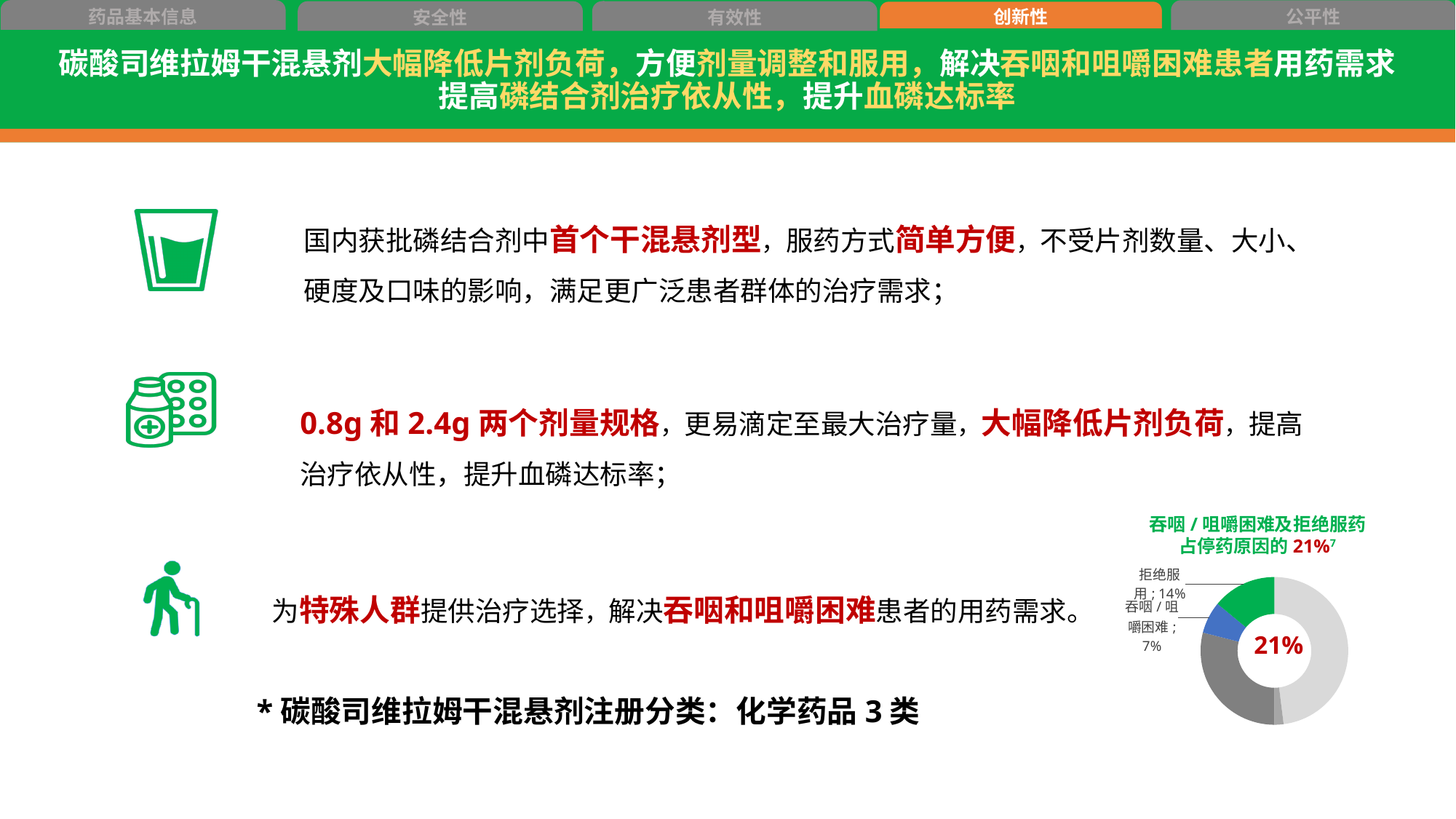
What is the difference between the share for 拒绝服用 and the share for 吞咽/咀嚼困难? 7% What share of the pie is labelled for 吞咽/咀嚼困难? 7% Is the share for 拒绝服用 greater or less than 10%? greater What share of the pie is labelled for 拒绝服用? 14% What value is printed in the centre of the donut chart? 21% How many slices does the donut chart have? 5 What is the title of the chart? 吞咽/咀嚼困难及拒绝服药占停药原因的 21% What is the combined share of 拒绝服用 and 吞咽/咀嚼困难? 21% Which is larger, the share for 拒绝服用 or the share for 吞咽/咀嚼困难? 拒绝服用 What kind of chart is shown on the slide? Pie chart (donut)